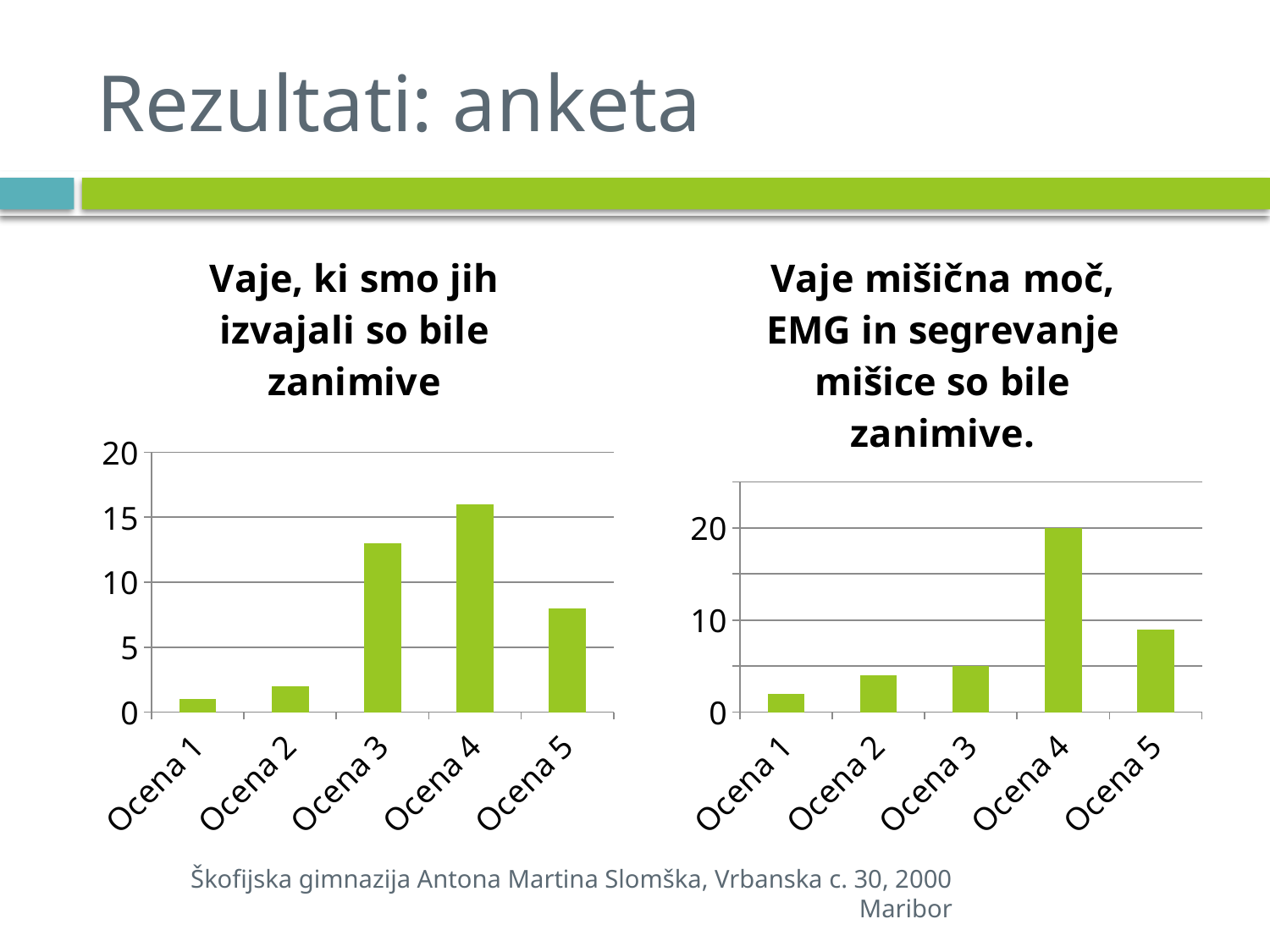
In the left chart, which is larger, the value for Ocena 3 or the value for Ocena 5? Ocena 3 In the left chart, which category has the highest bar? Ocena 4 In the left chart, is the value for Ocena 3 greater or less than 10? greater In the right chart, which category has the highest bar? Ocena 4 In the left chart, which category has the lowest bar? Ocena 1 In the right chart, which category has the lowest bar? Ocena 1 What is the title of the left chart? Vaje, ki smo jih izvajali so bile zanimive In the left chart, is the value for Ocena 5 greater or less than 10? less In the right chart, is the value for Ocena 5 greater or less than 10? less In the right chart, what is the value for Ocena 4? 20 How many categories are shown on the x axis of the right chart titled "Vaje mišična moč, EMG in segrevanje mišice so bile zanimive."? 5 What kind of chart is the left chart titled "Vaje, ki smo jih izvajali so bile zanimive"? bar chart